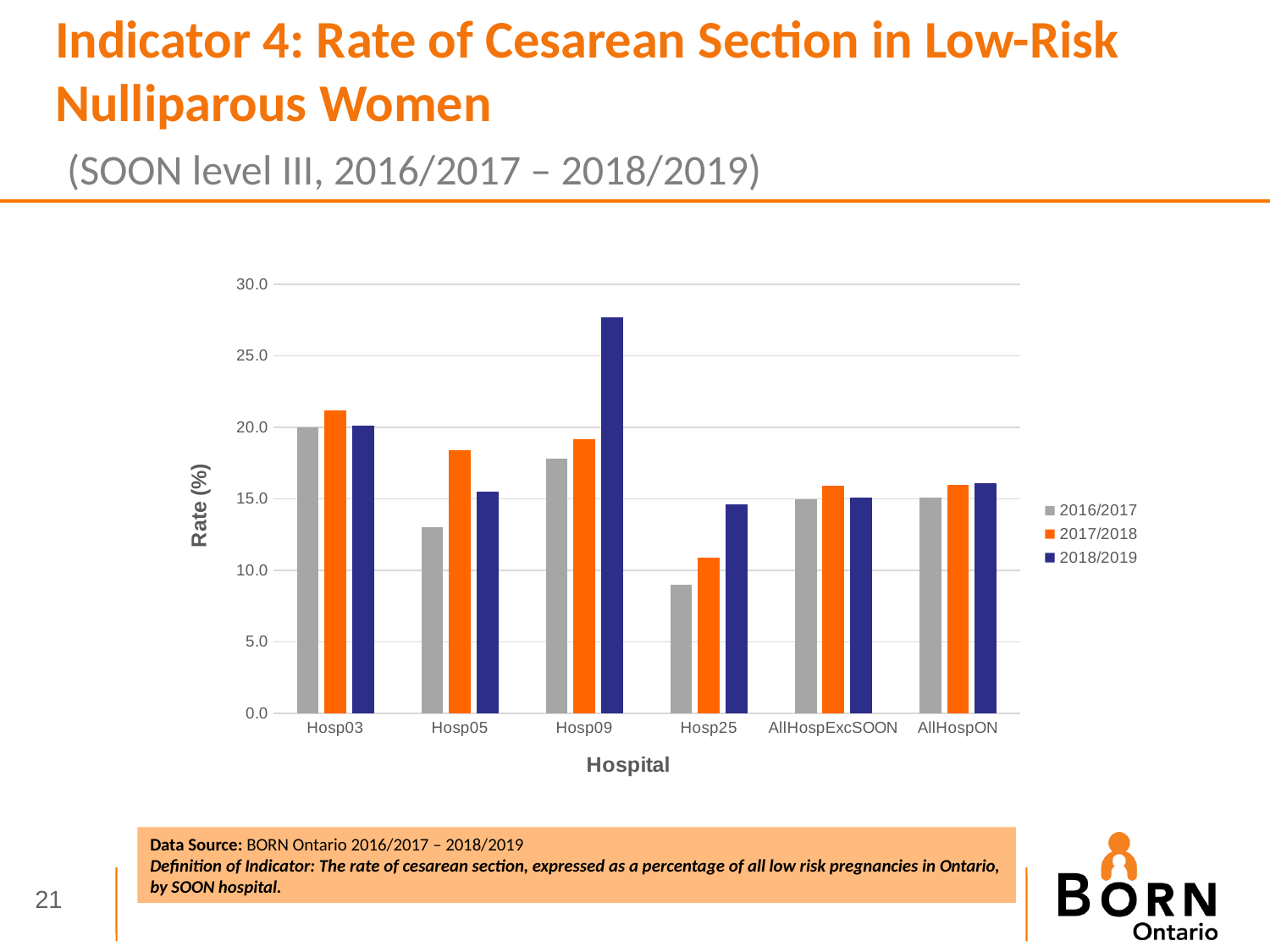
Which hospital and year has the lowest bar in the chart? Hosp25, 2016/2017 Is the 2016/2017 value for Hosp25 greater or less than 10.0? less For Hosp05, which is larger: the 2017/2018 value or the 2018/2019 value? 2017/2018 For Hosp25, do the values rise or fall from 2016/2017 to 2018/2019? Rise What is the title of the y axis? Rate (%) Is the 2018/2019 value for Hosp09 greater or less than 25.0? greater What kind of chart is shown on the slide? Bar chart How many hospital categories are shown on the x axis? 6 How many series does the legend list? 3 Which hospital and year has the highest bar in the chart? Hosp09, 2018/2019 For 2017/2018, which hospital has the larger value: Hosp03 or Hosp09? Hosp03 Is the 2016/2017 value for Hosp05 greater or less than 15.0? less